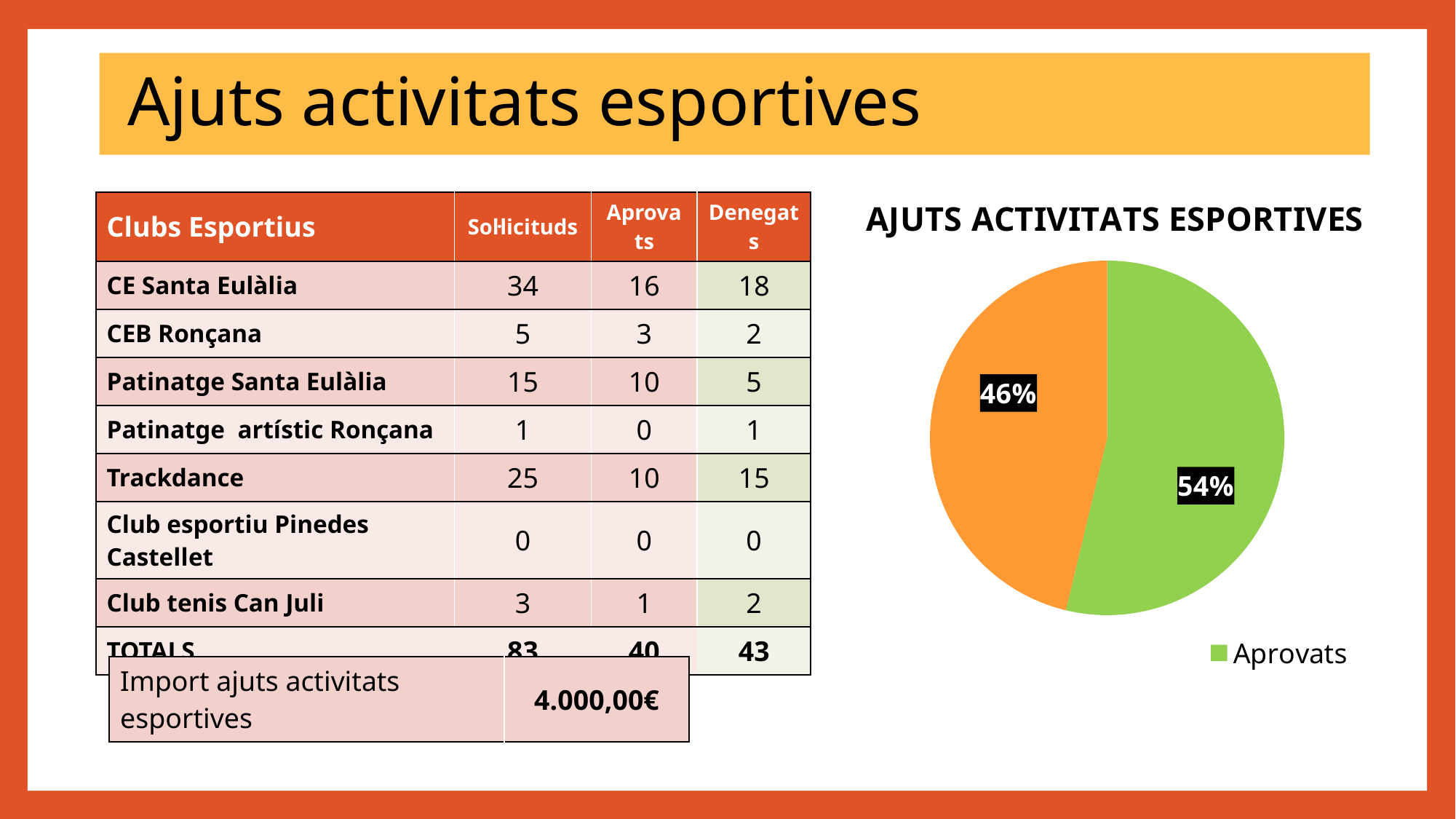
Is the Aprovats slice larger or smaller than the orange slice? larger What kind of chart is shown on the slide? pie chart What is the title of the pie chart? AJUTS ACTIVITATS ESPORTIVES How many entries does the pie chart's legend list? 1 How many slices does the pie chart have? 2 Which slice of the pie chart is the largest? Aprovats Is the share for Aprovats greater or less than 50%? greater What percentage is shown on the orange slice of the pie chart? 46% What share of the pie chart does Aprovats represent? 54% What is the difference in percentage points between the Aprovats slice and the orange slice? 8 Which entry is listed in the pie chart's legend? Aprovats